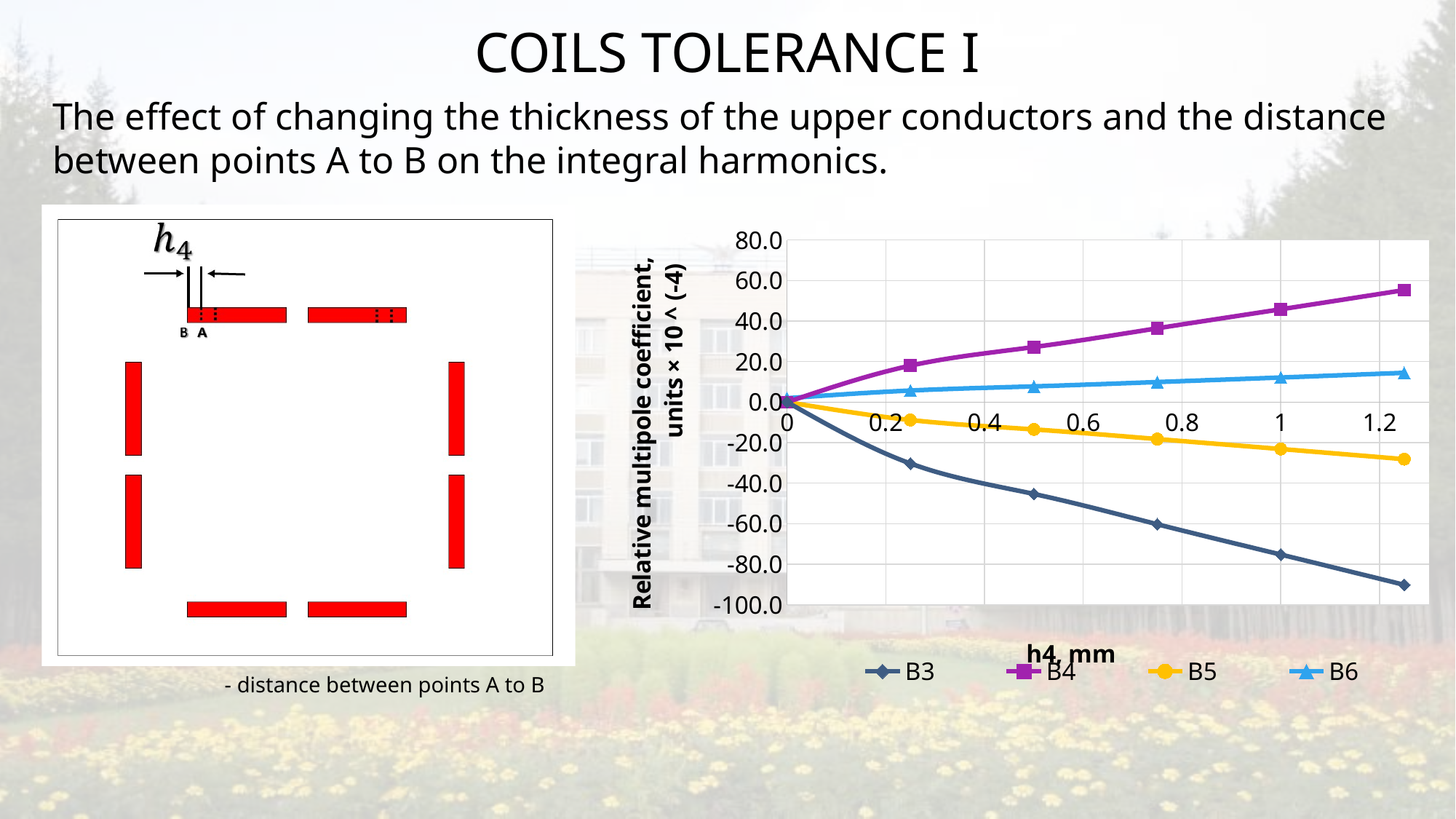
How many series does the chart legend list? 4 Is the value of B3 at the largest h4 plotted greater or less than -80.0? less Does the B4 series rise or fall as h4 increases? rise How many data points are plotted for the B4 series? 6 Is the value of B4 at the largest h4 plotted greater or less than 40.0? greater Which series reaches the lowest value on the chart? B3 What kind of chart is shown on the slide? line chart Does the B5 series rise or fall as h4 increases? fall Which series reaches the highest value on the chart? B4 What is the title of the x axis of the chart? h4, mm At the largest h4 plotted, which series has the larger value, B4 or B6? B4 Does the B3 series rise or fall as h4 increases? fall